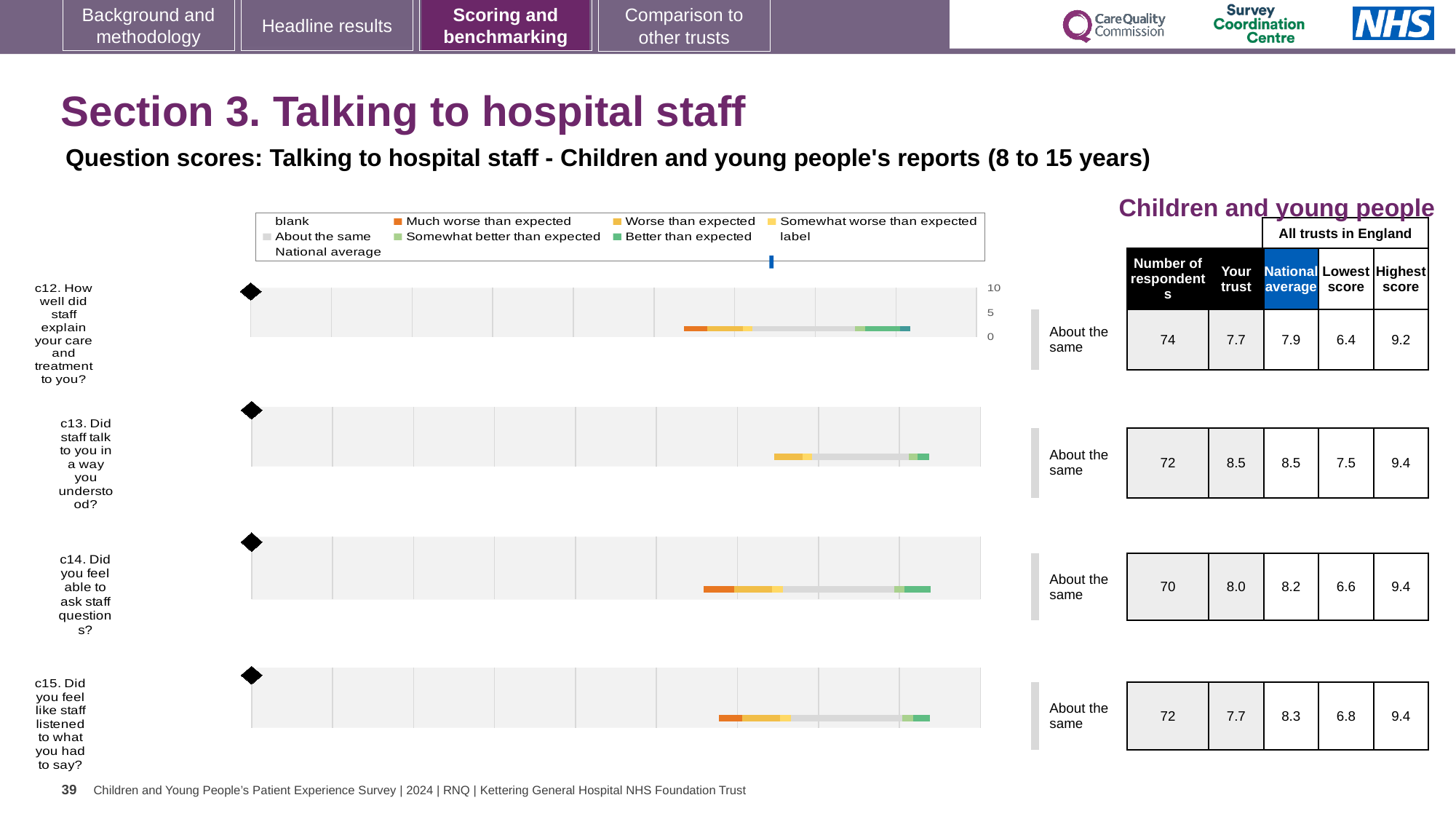
What benchmark category is shown for c12? About the same How many questions (c12 to c15) are plotted on the slide? 4 For c12 (How well did staff explain your care and treatment to you?), what is the 'Your trust' score? 7.7 What kind of chart is used for the question scores on this slide? bar chart For c14 (Did you feel able to ask staff questions?), how many respondents are there? 70 For c13 (Did staff talk to you in a way you understood?), what is the national average score? 8.5 For c15, what is the difference between the national average and the 'Your trust' score? 0.6 Which question has the lowest number of respondents? c14 For c14, which is larger: the 'Your trust' score or the national average? National average Which question has the highest 'Your trust' score? c13 For c15 (Did you feel like staff listened to what you had to say?), what is the lowest score among all trusts in England? 6.8 For c12, what is the highest score among all trusts in England? 9.2